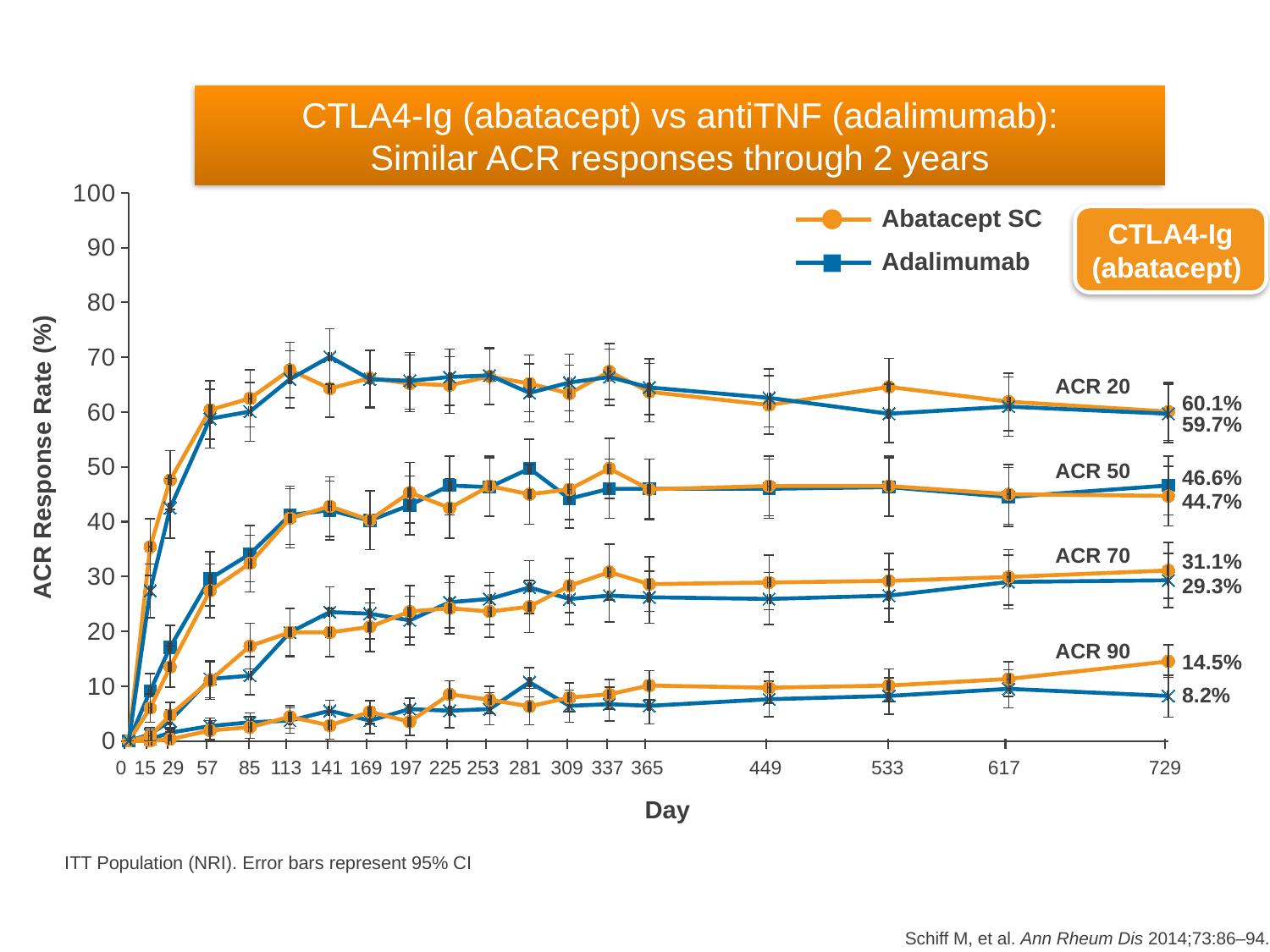
At day 729, which treatment has the higher ACR 90 response rate? Abatacept SC What is the difference between the ACR 70 response rates of Abatacept SC (31.1%) and Adalimumab (29.3%) at day 729? 1.8% What is the ACR 90 response rate for Adalimumab at day 729? 8.2% What is the label of the y axis? ACR Response Rate (%) What is the ACR 50 response rate for Adalimumab at day 729? 46.6% What kind of chart is shown on the slide? line chart What is the difference between the ACR 90 response rates of Abatacept SC and Adalimumab at day 729? 6.3% How many series does the legend list? 2 What is the ACR 90 response rate for Abatacept SC at day 729? 14.5% What is the ACR 20 response rate for Adalimumab at day 729? 59.7% Is the ACR 20 response rate for Abatacept SC at day 113 greater or less than 50? greater What is the ACR 20 response rate for Abatacept SC at day 729? 60.1%